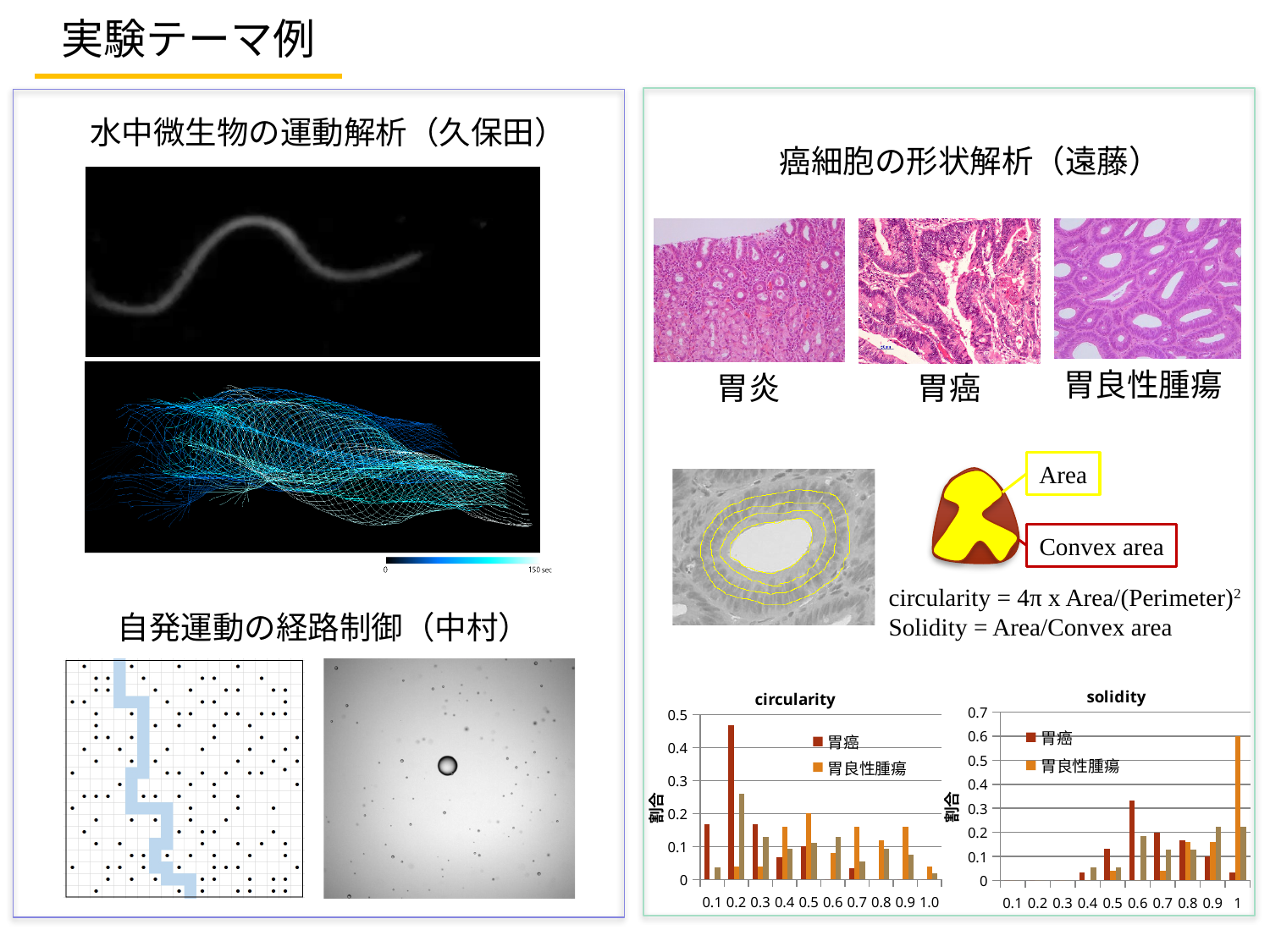
What kind of chart is the "circularity" chart? bar chart In the "solidity" chart, at which x-axis value is the tallest 胃癌 bar? 0.6 In the "circularity" chart, at x = 0.2, which series has the larger value, 胃癌 or 胃良性腫瘍? 胃癌 How many series does the legend of the "circularity" chart list? 2 In the "circularity" chart, is the 胃良性腫瘍 value at 0.2 greater or less than 0.1? less In the "circularity" chart, is the 胃癌 value at 0.2 greater or less than 0.4? greater How many categories are shown on the x axis of the "solidity" chart? 10 In the "circularity" chart, at which x-axis value is the tallest 胃癌 bar? 0.2 What is the y-axis label of the "solidity" chart? 割合 What kind of chart is the "solidity" chart? bar chart In the "solidity" chart, is the 胃良性腫瘍 value at 1 greater or less than 0.5? greater In the "solidity" chart, at which x-axis value is the tallest 胃良性腫瘍 bar? 1